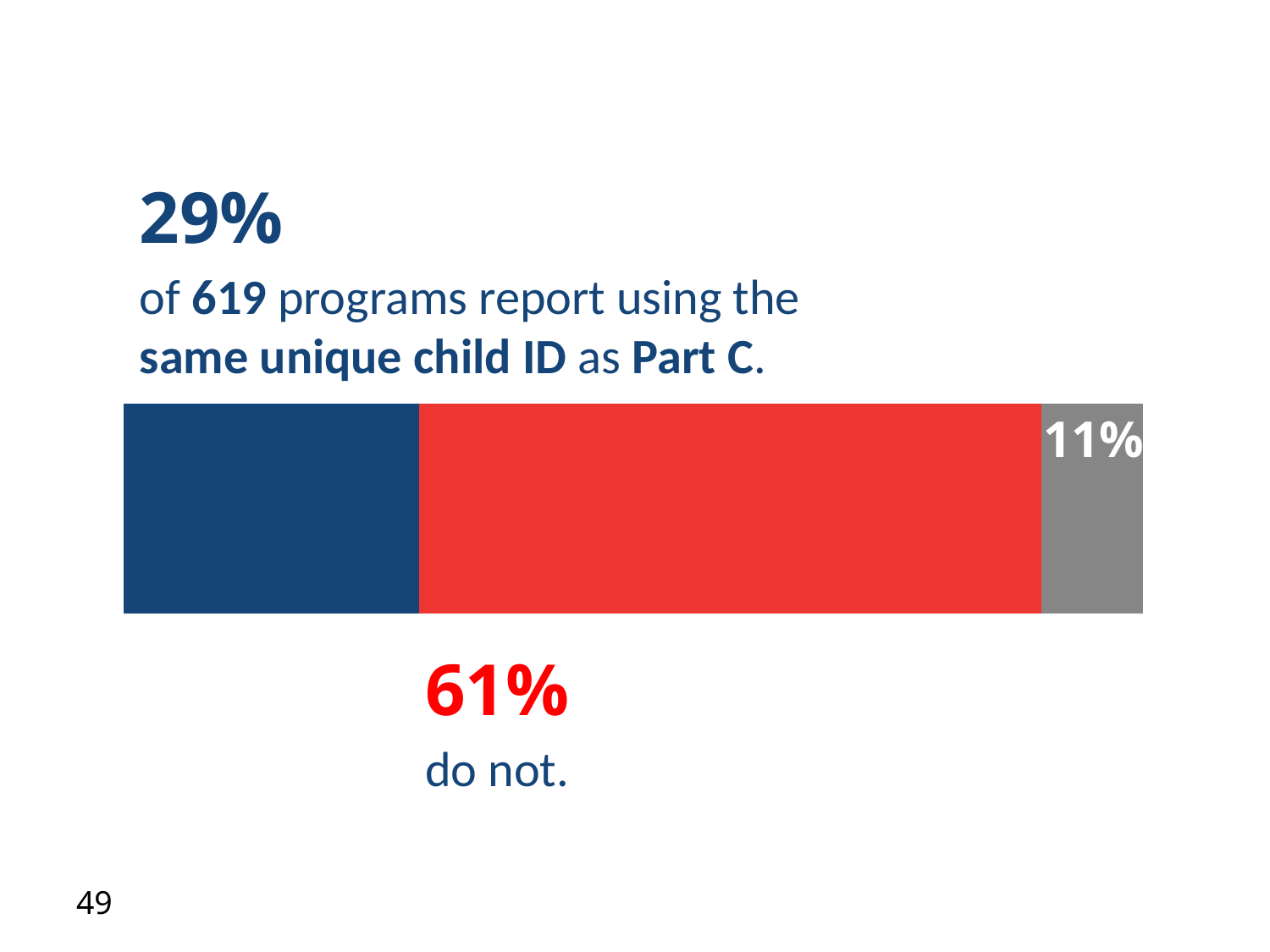
What is the difference in percentage points between the blue segment (29%) and the gray segment (11%)? 18 percentage points How many segments does the stacked bar have? 3 Which segment of the bar is the largest? The red segment (61%, do not) What colour is the segment representing the 61% of programs that do not use the same unique child ID? Red What percentage of 619 programs do not use the same unique child ID as Part C? 61% What percentage of 619 programs report using the same unique child ID as Part C? 29% Which is larger: the share of programs using the same unique child ID as Part C, or the share that do not? The share that do not (61%) What kind of chart is shown on the slide? A stacked bar chart What value is printed on the gray segment of the bar? 11% What colour is the segment representing the 29% of programs that use the same unique child ID as Part C? Blue What is the difference in percentage points between programs that do not use the same unique child ID (61%) and those that do (29%)? 32 percentage points Which segment of the bar is the smallest? The gray segment (11%)